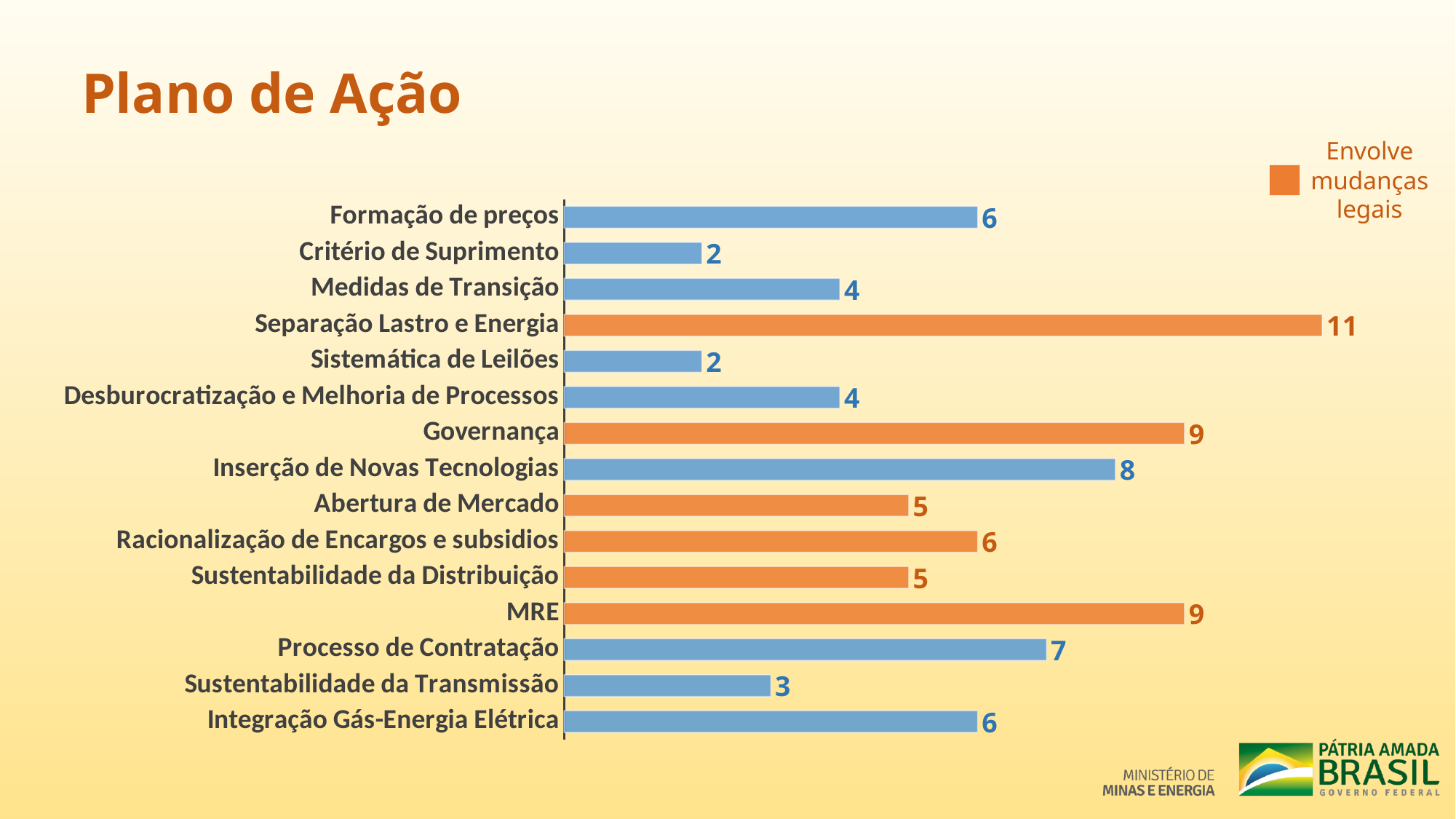
Which is larger, the value for Processo de Contratação or the value for Abertura de Mercado? Processo de Contratação What does the orange colour in the legend indicate? Envolve mudanças legais How many categories are shown in the chart? 15 What is the value for Separação Lastro e Energia? 11 What is the value for Sustentabilidade da Transmissão? 3 What is the difference between the values for Formação de preços and Critério de Suprimento? 4 What is the title of the slide? Plano de Ação What is the value for MRE? 9 What kind of chart is shown on the slide? Bar chart What is the value for Inserção de Novas Tecnologias? 8 Which category has the highest value? Separação Lastro e Energia What is the difference between the values for Separação Lastro e Energia and Governança? 2